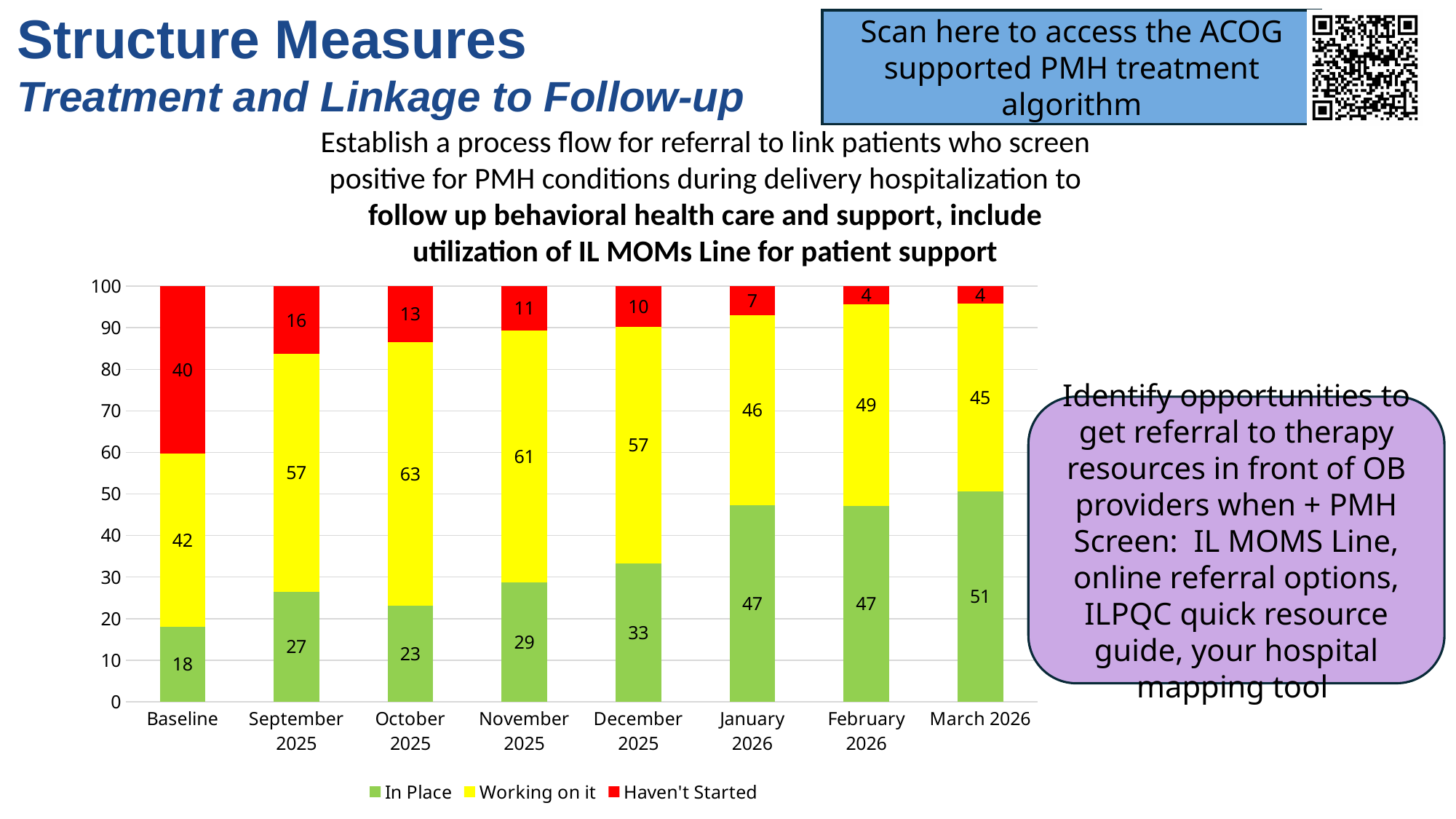
Which category has the highest Working on it value? October 2025 How many series does the legend list? 3 What is the difference between the In Place value for March 2026 and the In Place value for Baseline? 33 What kind of chart is shown on the slide? Stacked bar chart Which category has the highest In Place value? March 2026 How many categories are shown on the x axis? 8 Does the Haven't Started value rise or fall from Baseline to March 2026? Fall What is the Working on it value for October 2025? 63 Which category has the highest Haven't Started value? Baseline What is the value of the In Place series for December 2025? 33 What is the Haven't Started value for Baseline? 40 Which is larger, the Working on it value for September 2025 or for November 2025? November 2025